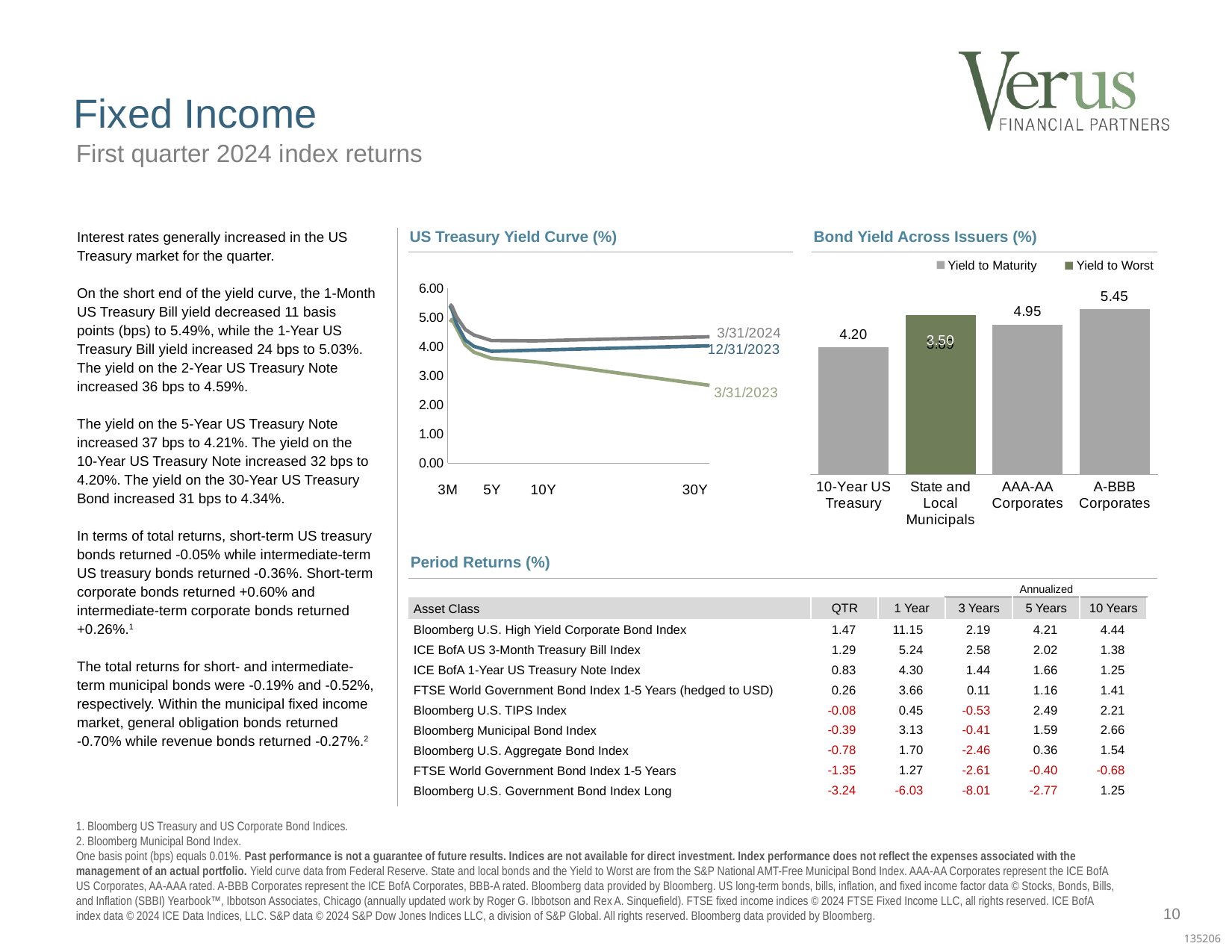
In the US Treasury Yield Curve (%) chart, does the 3/31/2023 line rise or fall from 5Y to 30Y? fall In the US Treasury Yield Curve (%) chart, is the 3/31/2023 value at 30Y greater or less than 3.00? less In the Bond Yield Across Issuers (%) chart, what is the value for AAA-AA Corporates? 4.95 In the Bond Yield Across Issuers (%) chart, what is the value for A-BBB Corporates? 5.45 How many series does the legend of the Bond Yield Across Issuers (%) chart list? 2 How many issuer categories are shown in the Bond Yield Across Issuers (%) chart? 4 In the Bond Yield Across Issuers (%) chart, what is the value for the 10-Year US Treasury? 4.20 In the Bond Yield Across Issuers (%) chart, which issuer has the highest yield? A-BBB Corporates In the Bond Yield Across Issuers (%) chart, which is larger: AAA-AA Corporates or 10-Year US Treasury? AAA-AA Corporates In the Bond Yield Across Issuers (%) chart, what is the difference between A-BBB Corporates and AAA-AA Corporates? 0.50 What kind of chart is the Bond Yield Across Issuers (%) chart? Bar chart In the US Treasury Yield Curve (%) chart, is the 3/31/2024 value at 3M greater or less than 5.00? greater